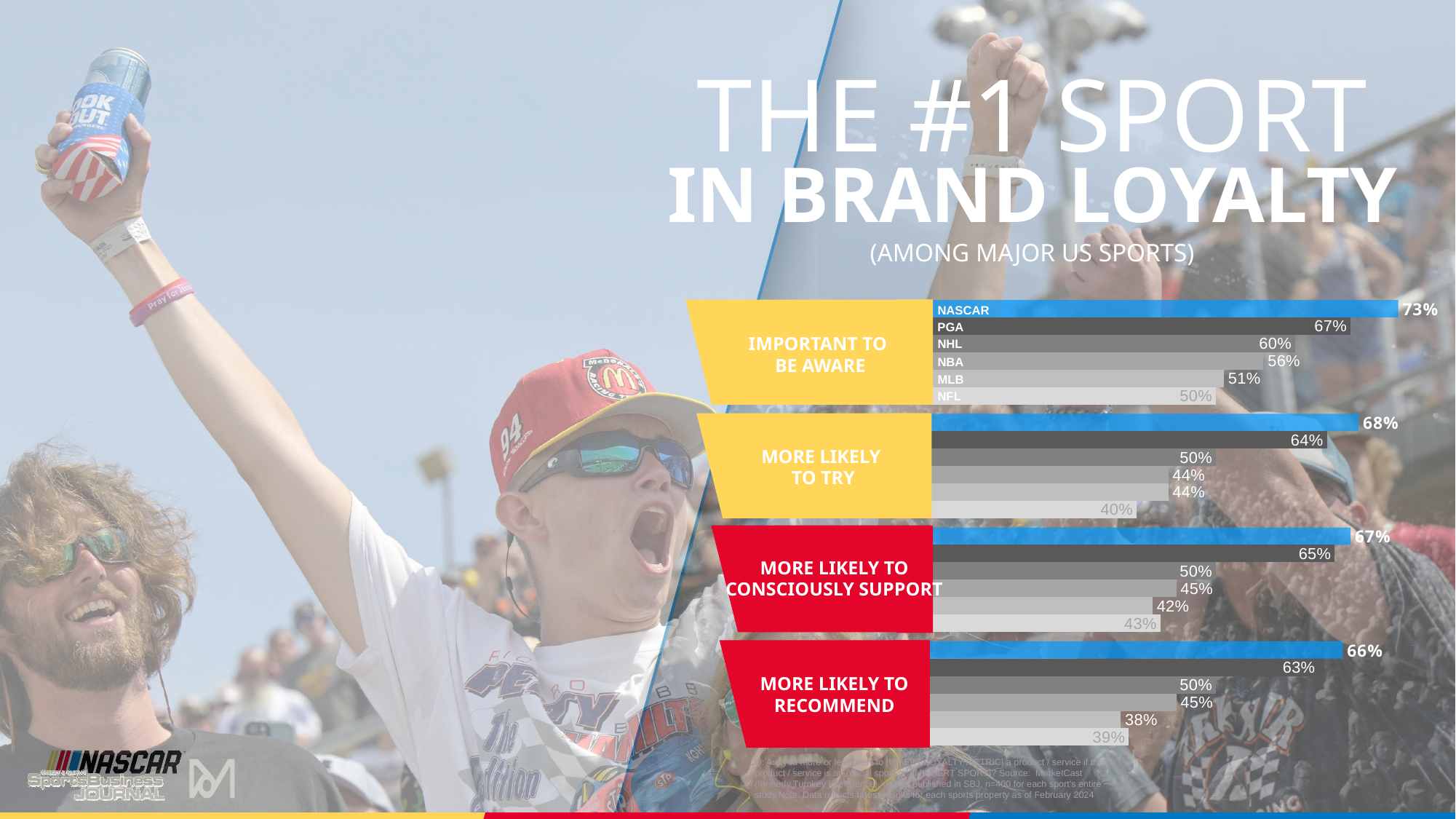
In the 'Important to be aware' chart, what is the value for NASCAR? 73% What kind of chart is used on this slide? Bar chart In the 'Important to be aware' chart, which is larger, the value for NBA or the value for MLB? NBA In the 'Important to be aware' chart, what is the difference between the NASCAR and PGA values? 6 percentage points In the 'More likely to try' chart, what is the value of the top (blue) bar? 68% In the 'Important to be aware' chart, what is the value for NHL? 60% In the 'Important to be aware' chart, which sport has the lowest value? NFL In the 'Important to be aware' chart, which sport has the highest value? NASCAR How many chart groups (metrics) are shown on the slide? 4 How many sports are shown in the 'Important to be aware' chart? 6 In the 'More likely to consciously support' chart, what is the value of the second bar from the top? 65%